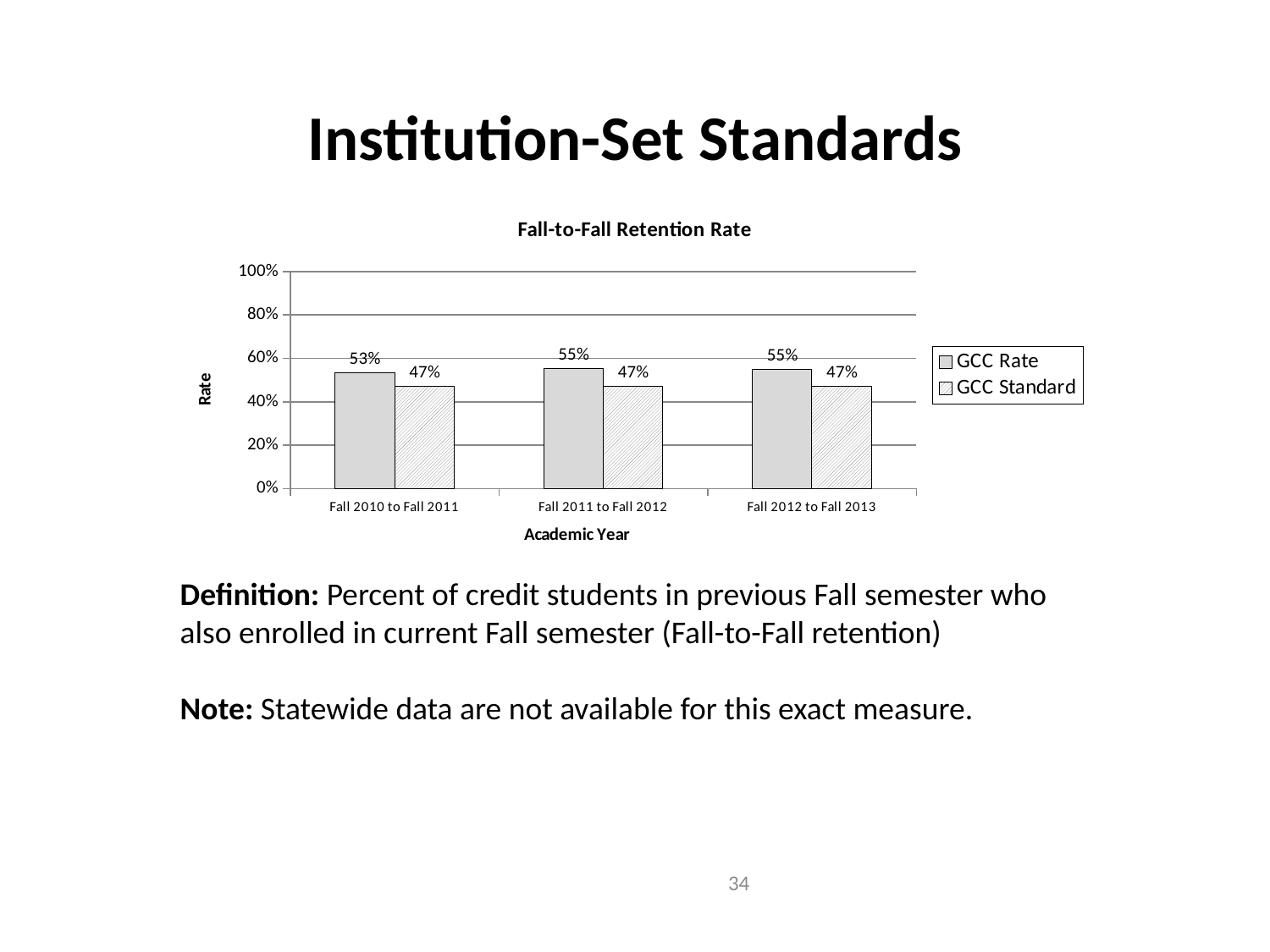
What is the GCC Rate for Fall 2010 to Fall 2011? 53% Which is larger for Fall 2012 to Fall 2013, the GCC Rate or the GCC Standard? GCC Rate Which academic year has the lowest GCC Rate? Fall 2010 to Fall 2011 How many academic years are shown on the x axis? 3 What is the GCC Rate for Fall 2011 to Fall 2012? 55% Is the GCC Rate for Fall 2011 to Fall 2012 greater or less than 80%? less What is the difference between the GCC Rate and the GCC Standard for Fall 2011 to Fall 2012? 8% How many series does the legend list? 2 What is the GCC Standard for Fall 2012 to Fall 2013? 47% What is the title of the chart? Fall-to-Fall Retention Rate What is the difference between the GCC Rate and the GCC Standard for Fall 2010 to Fall 2011? 6% What kind of chart is shown on the slide? Bar chart